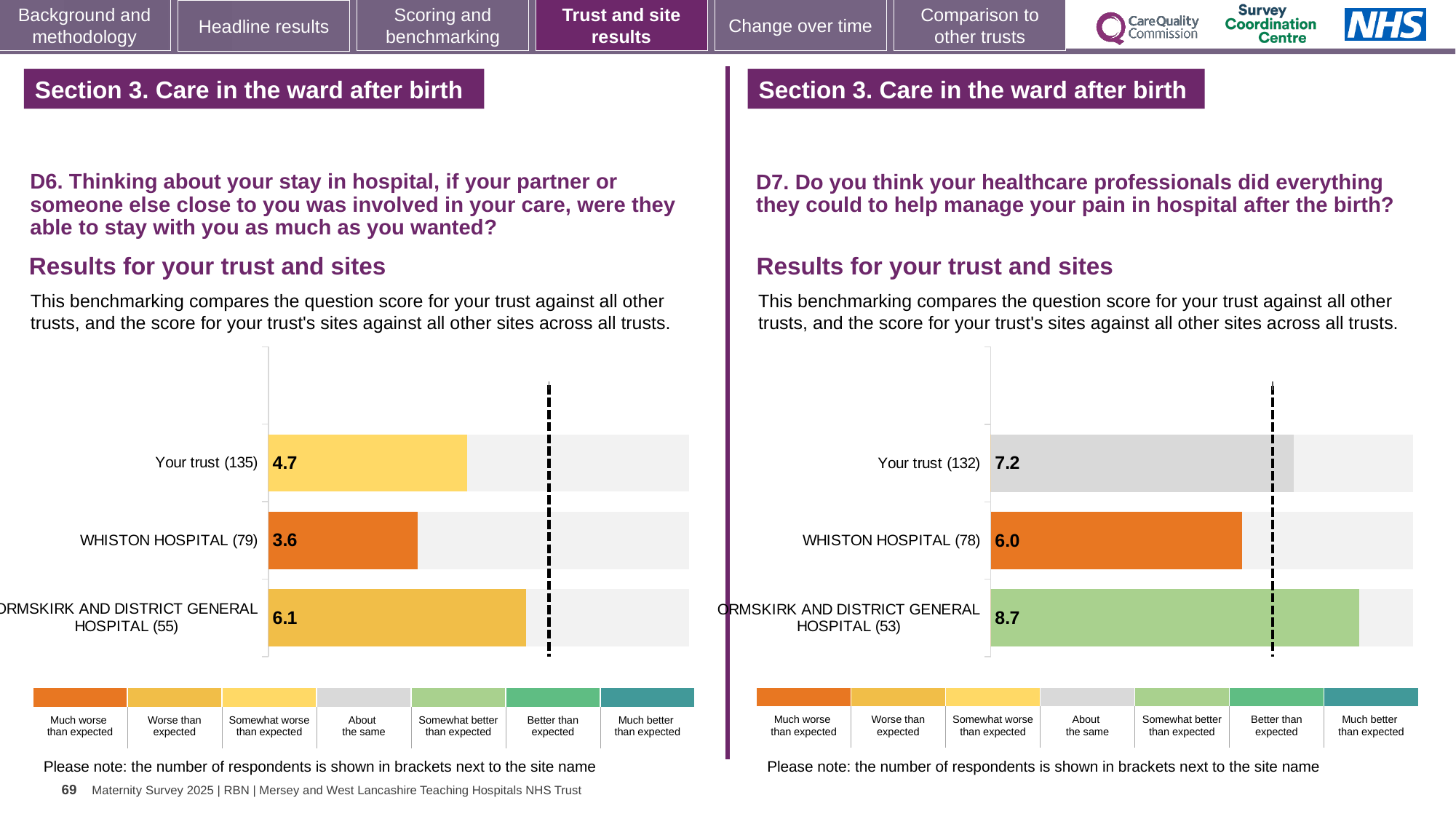
In the left chart (D6), which site or trust has the highest score? ORMSKIRK AND DISTRICT GENERAL HOSPITAL In the right chart (D7), what is the score for WHISTON HOSPITAL? 6.0 In the right chart (D7), what is the score for Your trust? 7.2 In the left chart (D6), what is the score for WHISTON HOSPITAL? 3.6 What type of chart is used in the left chart (D6)? Bar chart In the right chart (D7), which has the larger score, Your trust or WHISTON HOSPITAL? Your trust In the left chart (D6), what is the difference between the scores for ORMSKIRK AND DISTRICT GENERAL HOSPITAL and WHISTON HOSPITAL? 2.5 In the right chart (D7), what is the score for ORMSKIRK AND DISTRICT GENERAL HOSPITAL? 8.7 In the right chart (D7), what is the difference between the scores for ORMSKIRK AND DISTRICT GENERAL HOSPITAL and Your trust? 1.5 In the left chart (D6), what is the score for Your trust? 4.7 In the right chart (D7), which site or trust has the lowest score? WHISTON HOSPITAL In the left chart (D6), what is the score for ORMSKIRK AND DISTRICT GENERAL HOSPITAL? 6.1